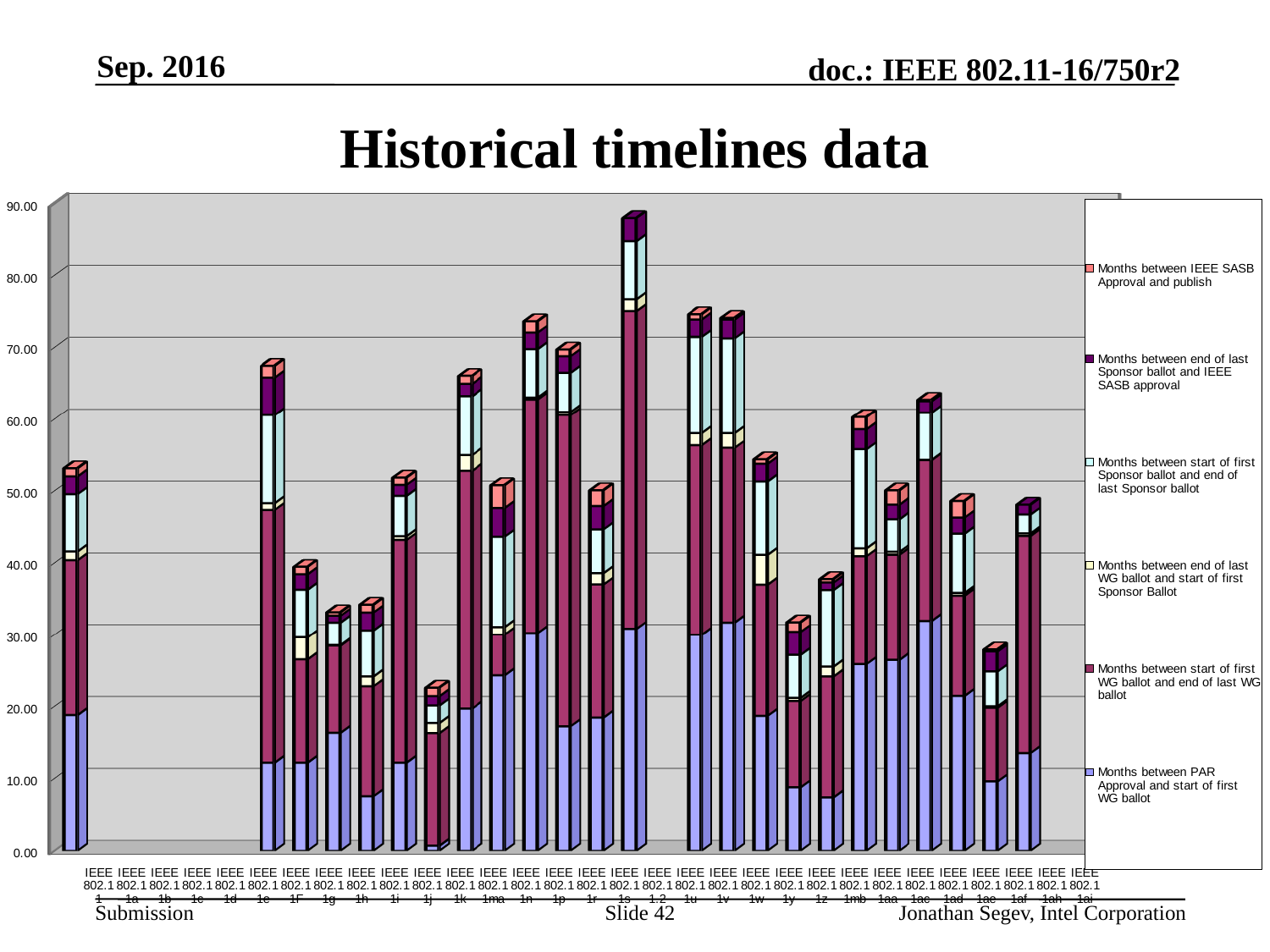
Which has the taller bar, IEEE 802.11 or IEEE 802.11s? IEEE 802.11s Is the total for IEEE 802.11s greater or less than 80? greater Is the total for IEEE 802.11j greater or less than 30? less What kind of chart is shown on the slide? Stacked bar chart Is the total for IEEE 802.11 greater or less than 40? greater Which has the taller bar, IEEE 802.11s or IEEE 802.11j? IEEE 802.11s What is the highest value shown on the vertical axis? 90.00 Which category has the tallest bar? IEEE 802.11s Which category has the shortest bar among those plotted? IEEE 802.11j What is the title of the chart? Historical timelines data How many series does the legend list? 6